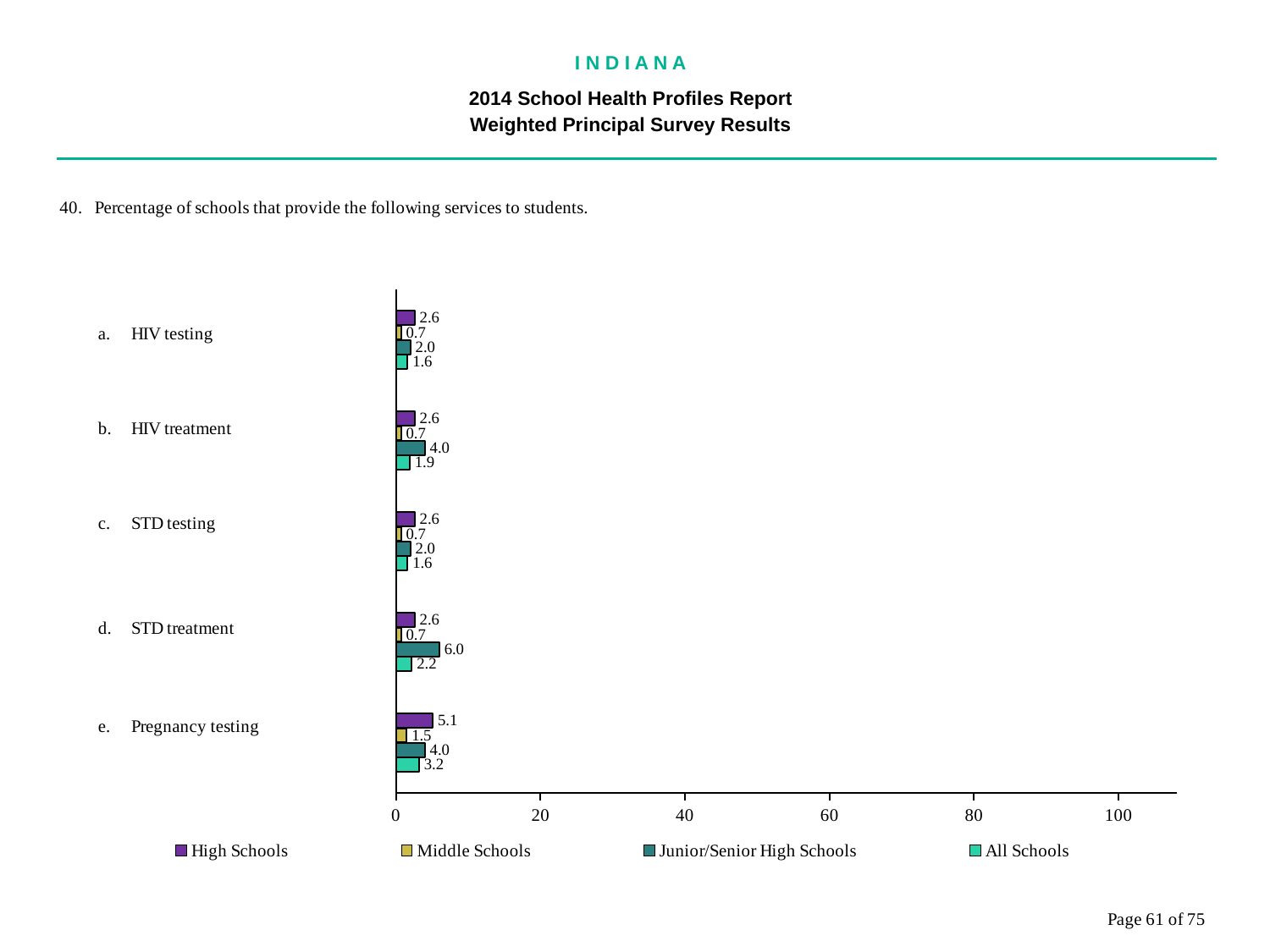
What kind of chart is shown on the slide? Bar chart How many services (categories) are shown on the chart? 5 Which service has the highest value for All Schools? Pregnancy testing What percentage of high schools provide pregnancy testing? 5.1 What is the value for All Schools for HIV treatment? 1.9 Is the value for High Schools for pregnancy testing greater or less than 20? less What is the difference between the Junior/Senior High Schools value and the Middle Schools value for STD treatment? 5.3 Which service has the highest value for Junior/Senior High Schools? STD treatment For HIV treatment, which is larger: the High Schools value or the Junior/Senior High Schools value? Junior/Senior High Schools What is the value for Middle Schools for pregnancy testing? 1.5 How many series does the legend list? 4 What is the value for Junior/Senior High Schools for STD treatment? 6.0